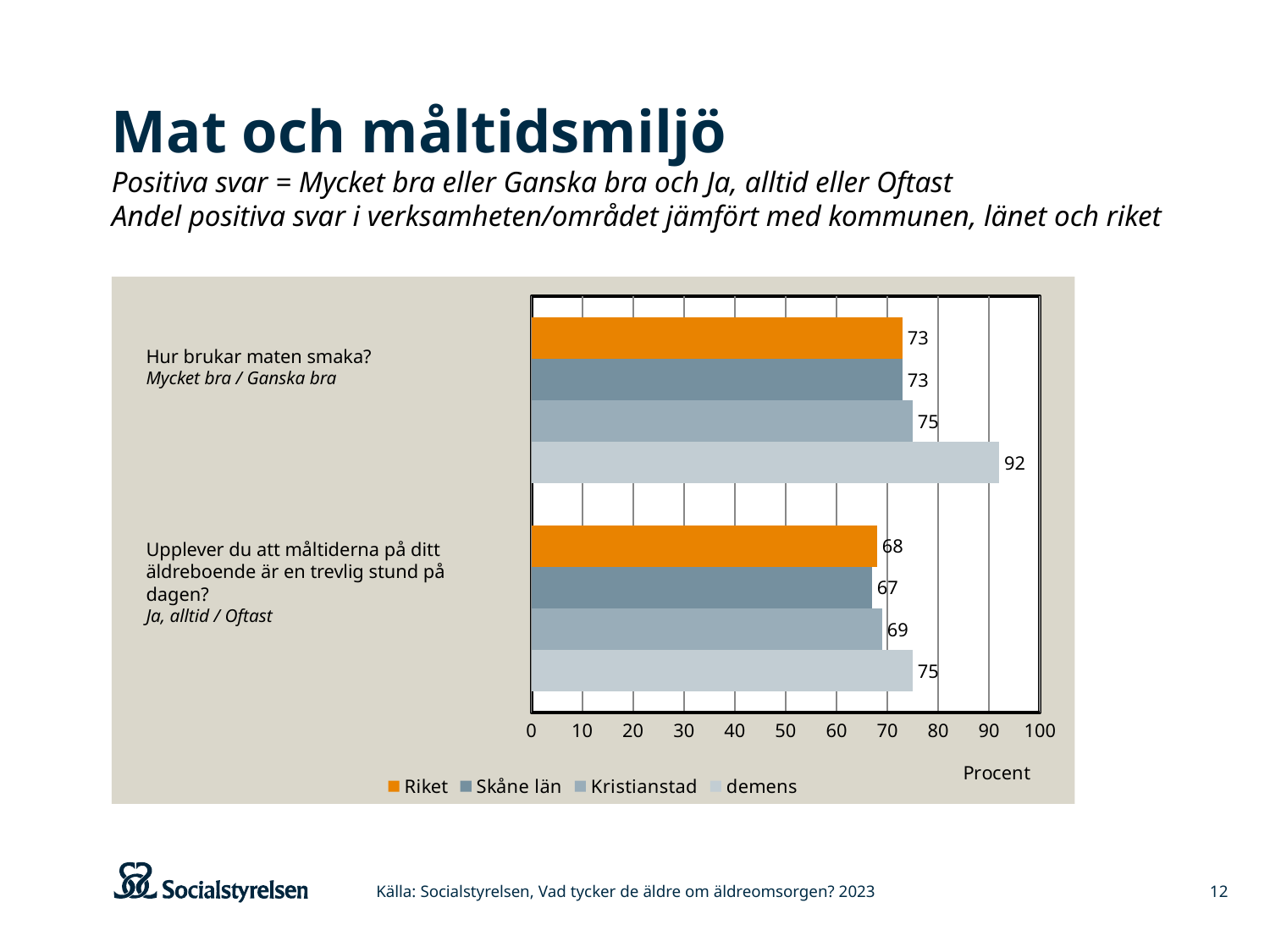
Which series has the highest value for the question "Hur brukar maten smaka?"? demens What is the difference between the demens value and the Kristianstad value for the question "Upplever du att måltiderna på ditt äldreboende är en trevlig stund på dagen?"? 6 How many series does the legend list? 4 Which is larger: the Kristianstad value for "Hur brukar maten smaka?" or the Kristianstad value for "Upplever du att måltiderna på ditt äldreboende är en trevlig stund på dagen?"? Hur brukar maten smaka? What kind of chart is shown on the slide? bar chart What is the value for demens for the question "Hur brukar maten smaka?"? 92 What is the value for Riket for the question "Hur brukar maten smaka?"? 73 What label is shown on the horizontal axis of the chart? Procent What is the difference between the demens value and the Riket value for the question "Hur brukar maten smaka?"? 19 What is the value for Skåne län for the question "Upplever du att måltiderna på ditt äldreboende är en trevlig stund på dagen?"? 67 Which series has the lowest value for the question "Upplever du att måltiderna på ditt äldreboende är en trevlig stund på dagen?"? Skåne län What is the value for Kristianstad for the question "Upplever du att måltiderna på ditt äldreboende är en trevlig stund på dagen?"? 69